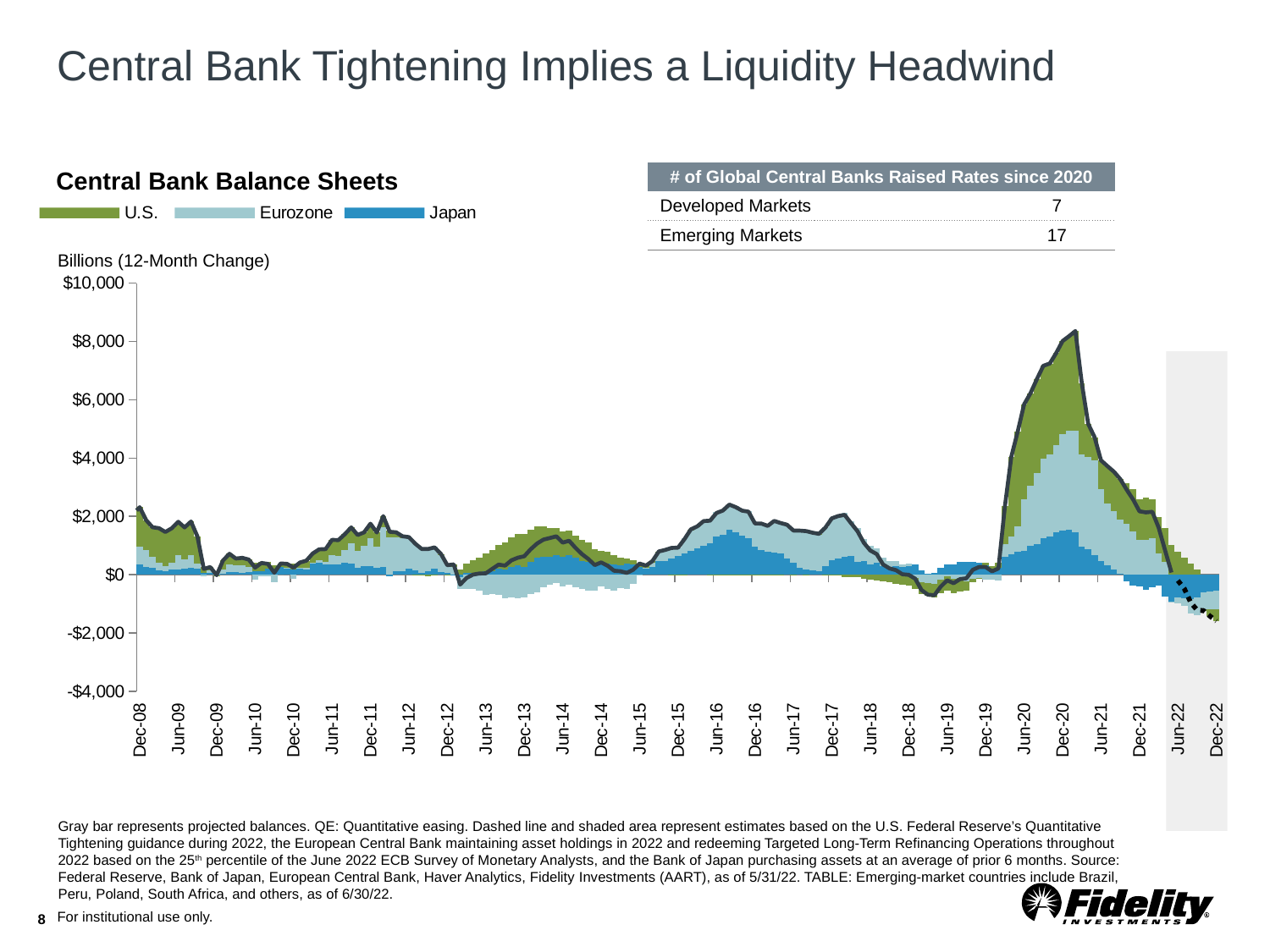
In the table '# of Global Central Banks Raised Rates since 2020', what is the value for Developed Markets? 7 In the Central Bank Balance Sheets chart, is the peak total value around Dec-20 greater or less than $6,000? greater How many series does the legend of the Central Bank Balance Sheets chart list? 3 Which series are listed in the legend of the Central Bank Balance Sheets chart? U.S., Eurozone, Japan What unit label is shown above the y-axis of the Central Bank Balance Sheets chart? Billions (12-Month Change) In the Central Bank Balance Sheets chart, is the total value around Jun-19 greater or less than $2,000? less What kind of chart is the Central Bank Balance Sheets chart? stacked bar chart with a line (combination bar and line chart) In the table '# of Global Central Banks Raised Rates since 2020', what is the difference between Emerging Markets and Developed Markets? 10 In the Central Bank Balance Sheets chart, is the total value at Dec-08 greater or less than $4,000? less In the Central Bank Balance Sheets chart, does the total value rise or fall between Dec-20 and Jun-22? fall In the Central Bank Balance Sheets chart, around which x-axis date does the total reach its highest value? Dec-20 In the table '# of Global Central Banks Raised Rates since 2020', what is the value for Emerging Markets? 17